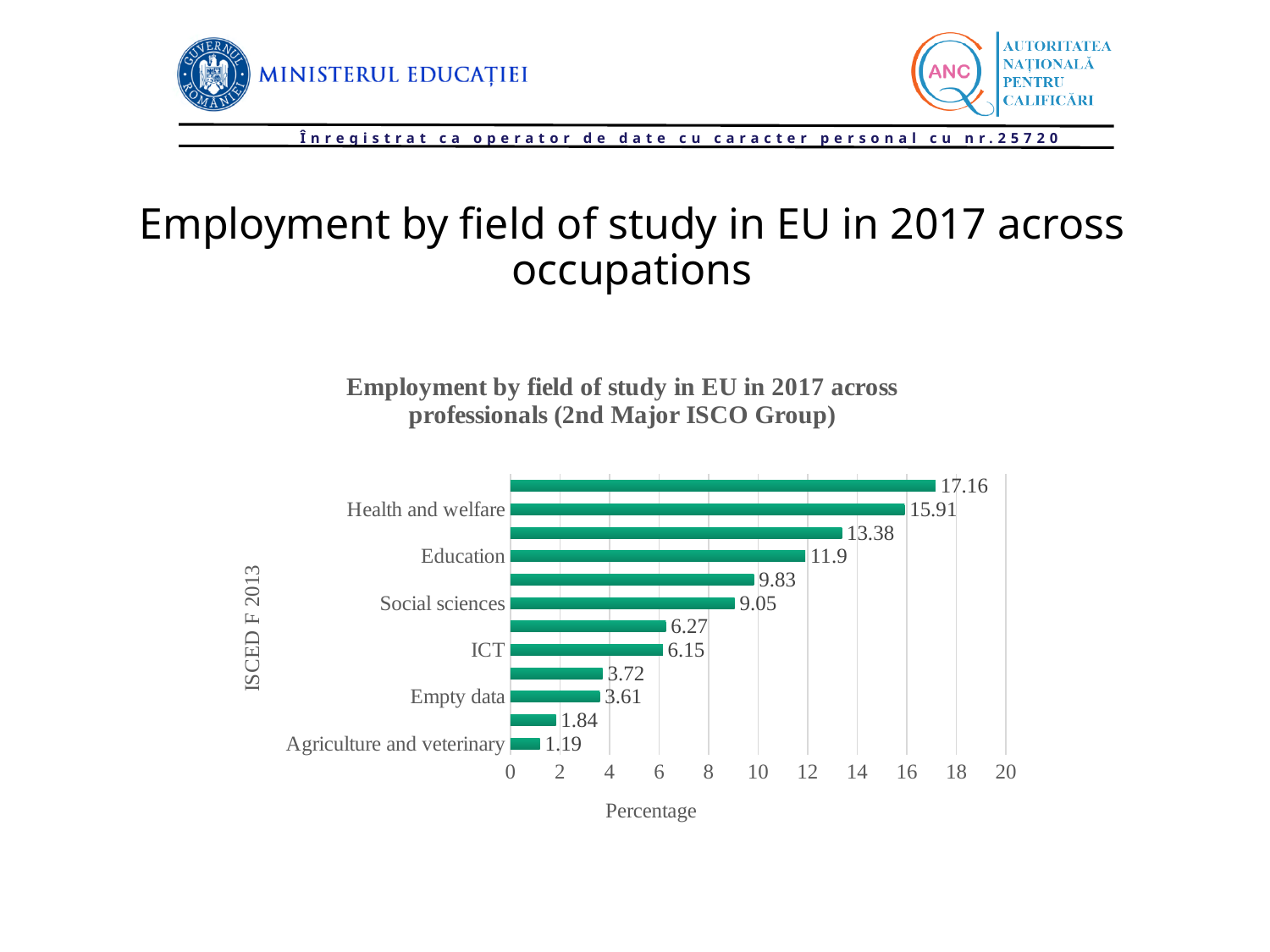
Which is larger, the value for Social sciences or the value for ICT? Social sciences What is the value for Agriculture and veterinary? 1.19 Among the labelled categories, which has the lowest value? Agriculture and veterinary What is the value of the longest bar in the chart? 17.16 What is the difference between the values for Health and welfare and Education? 4.01 What is the value for Education? 11.9 What is the value for Health and welfare? 15.91 How many bars are plotted in the chart? 12 What is the value for ICT? 6.15 What is the label of the horizontal axis? Percentage What kind of chart is shown on the slide? Bar chart What is the value for Social sciences? 9.05